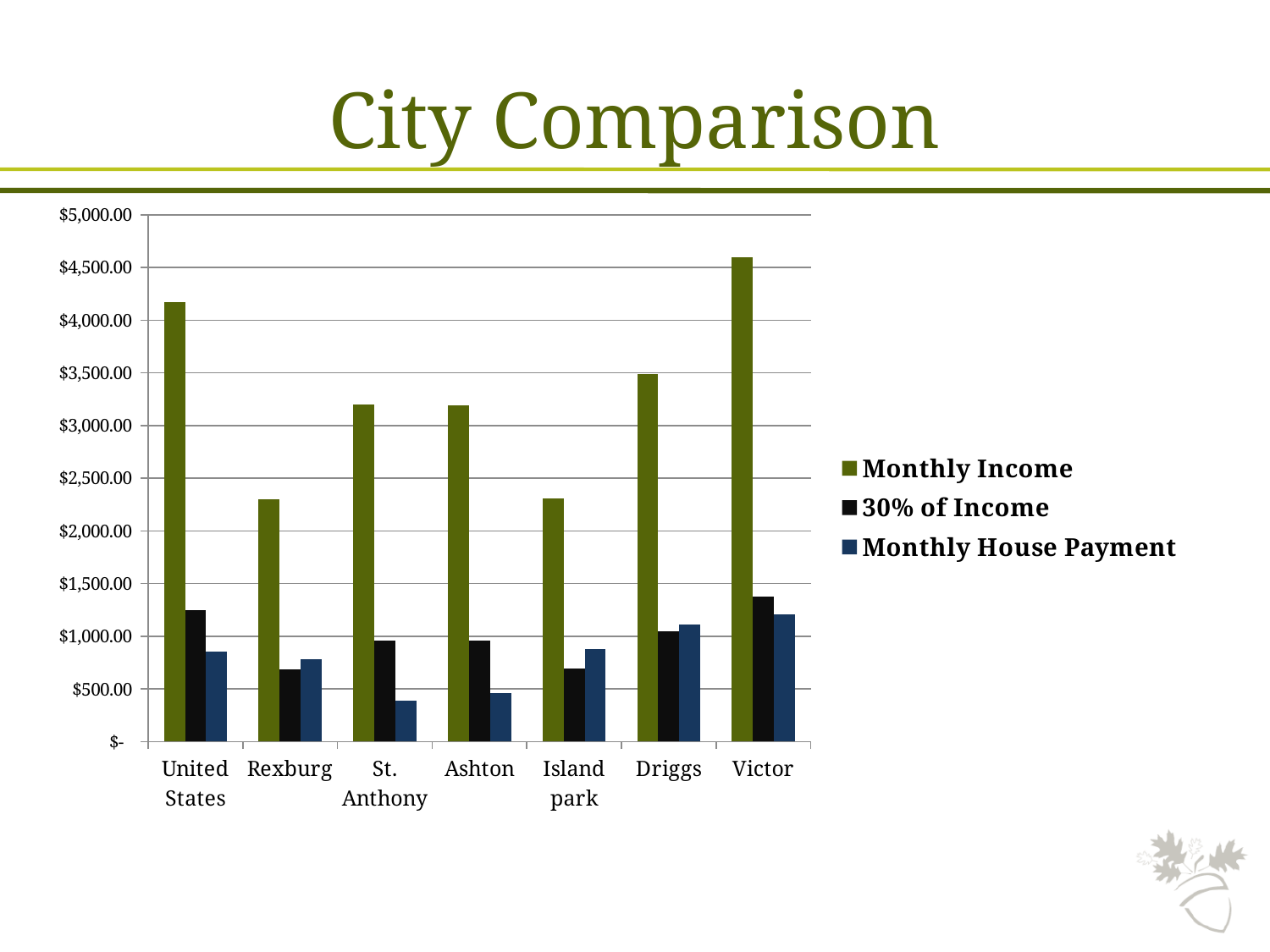
Which category has the lowest Monthly House Payment? St. Anthony How many cities or regions are shown on the x axis of the chart? 7 Is the Monthly Income for Rexburg greater or less than $2,500.00? less How many series does the chart's legend list? 3 Is the Monthly Income for United States greater or less than $4,000.00? greater Which category has the highest Monthly House Payment? Victor What is the title of the slide containing the chart? City Comparison Which category has the highest Monthly Income? Victor What kind of chart is shown on the slide? bar chart For Island park, which is larger: 30% of Income or Monthly House Payment? Monthly House Payment Is the Monthly House Payment for Driggs greater or less than $1,000.00? greater